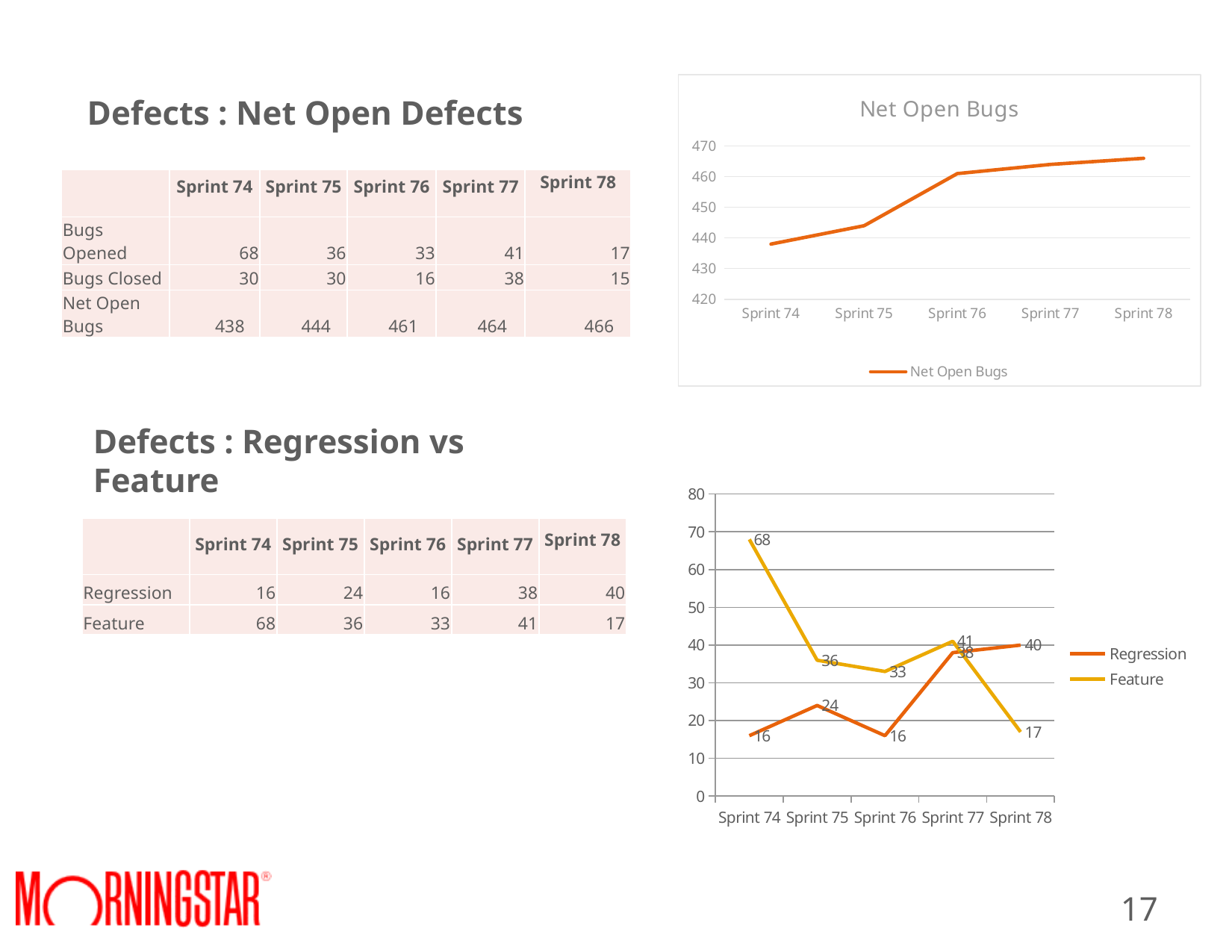
In the 'Net Open Bugs' chart, do the values rise or fall from Sprint 74 to Sprint 78? rise How many sprints are plotted on the x axis of the 'Net Open Bugs' chart? 5 In the bottom-right chart, which sprint has the highest Regression value? Sprint 78 In the 'Net Open Bugs' chart, is the value for Sprint 74 greater or less than 440? less What kind of chart is the 'Net Open Bugs' chart at the top right of the slide? line chart In the bottom-right chart, what is the Regression value for Sprint 78? 40 In the bottom-right chart, which sprint has the lowest Feature value? Sprint 78 In the 'Net Open Bugs' chart, is the value for Sprint 76 greater or less than 450? greater In the bottom-right chart, what is the difference between the Feature and Regression values for Sprint 74? 52 In the bottom-right chart, what is the Feature value for Sprint 74? 68 How many series does the legend of the bottom-right chart list? 2 In the bottom-right chart, which is larger for Sprint 78: Regression or Feature? Regression